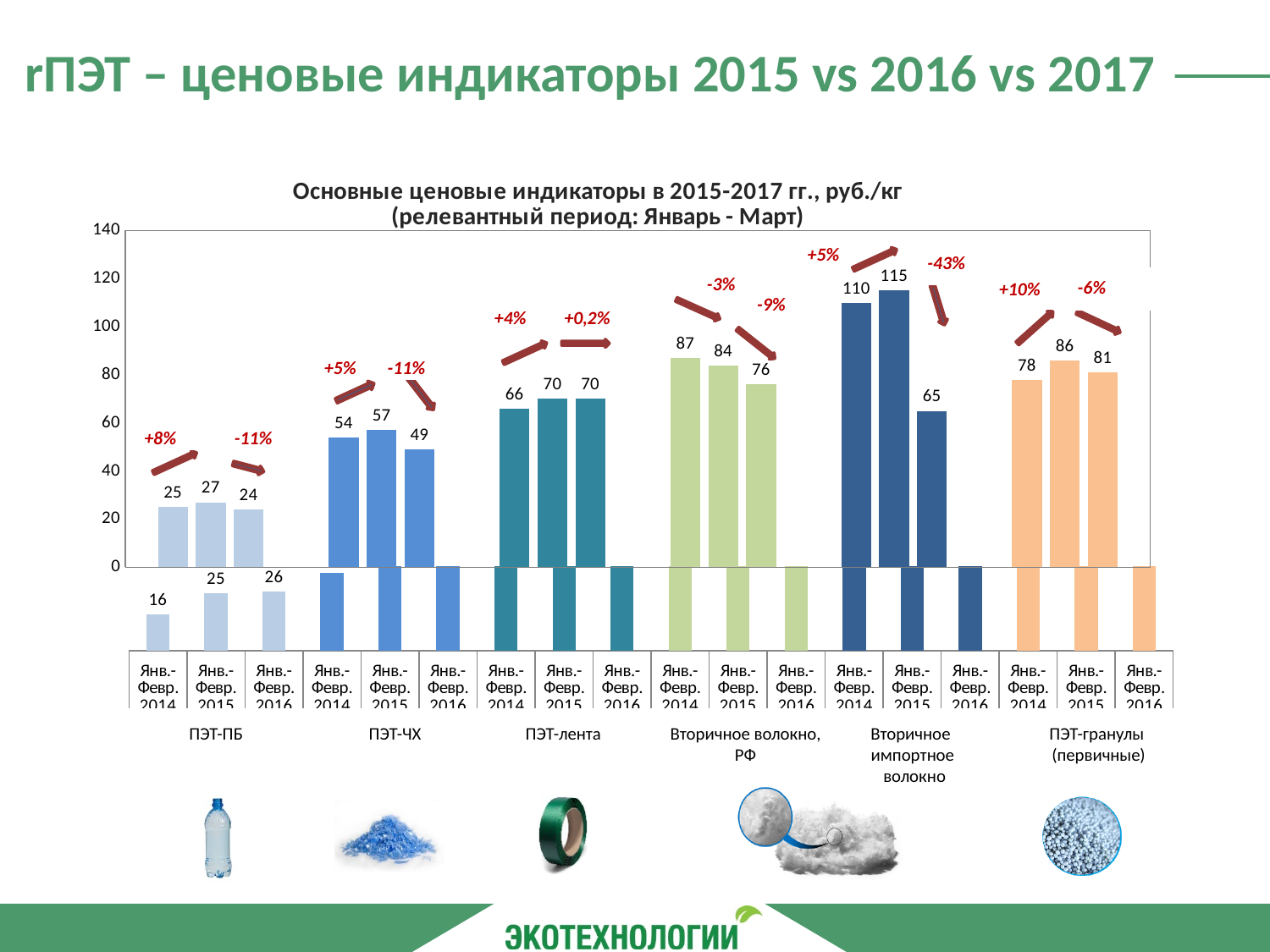
What is the value for ПЭТ-ЧХ in Янв.-Февр. 2015? 57 What type of chart is shown on the slide? bar chart What is the value for Вторичное импортное волокно in Янв.-Февр. 2016? 65 What is the difference between the Янв.-Февр. 2015 and Янв.-Февр. 2016 values for Вторичное импортное волокно? 50 Which product group has the highest value in Янв.-Февр. 2015? Вторичное импортное волокно Which product group has the lowest value in Янв.-Февр. 2016? ПЭТ-ПБ What percentage change is shown between Янв.-Февр. 2015 and Янв.-Февр. 2016 for Вторичное импортное волокно? -43% What is the value for ПЭТ-гранулы (первичные) in Янв.-Февр. 2014? 78 Which is larger: the Янв.-Февр. 2016 value for Вторичное волокно, РФ or for ПЭТ-гранулы (первичные)? ПЭТ-гранулы (первичные) What is the title of the chart? Основные ценовые индикаторы в 2015-2017 гг., руб./кг (релевантный период: Январь - Март) Is the Янв.-Февр. 2014 value for ПЭТ-лента greater or less than 60? greater How many product groups are shown on the x axis? 6